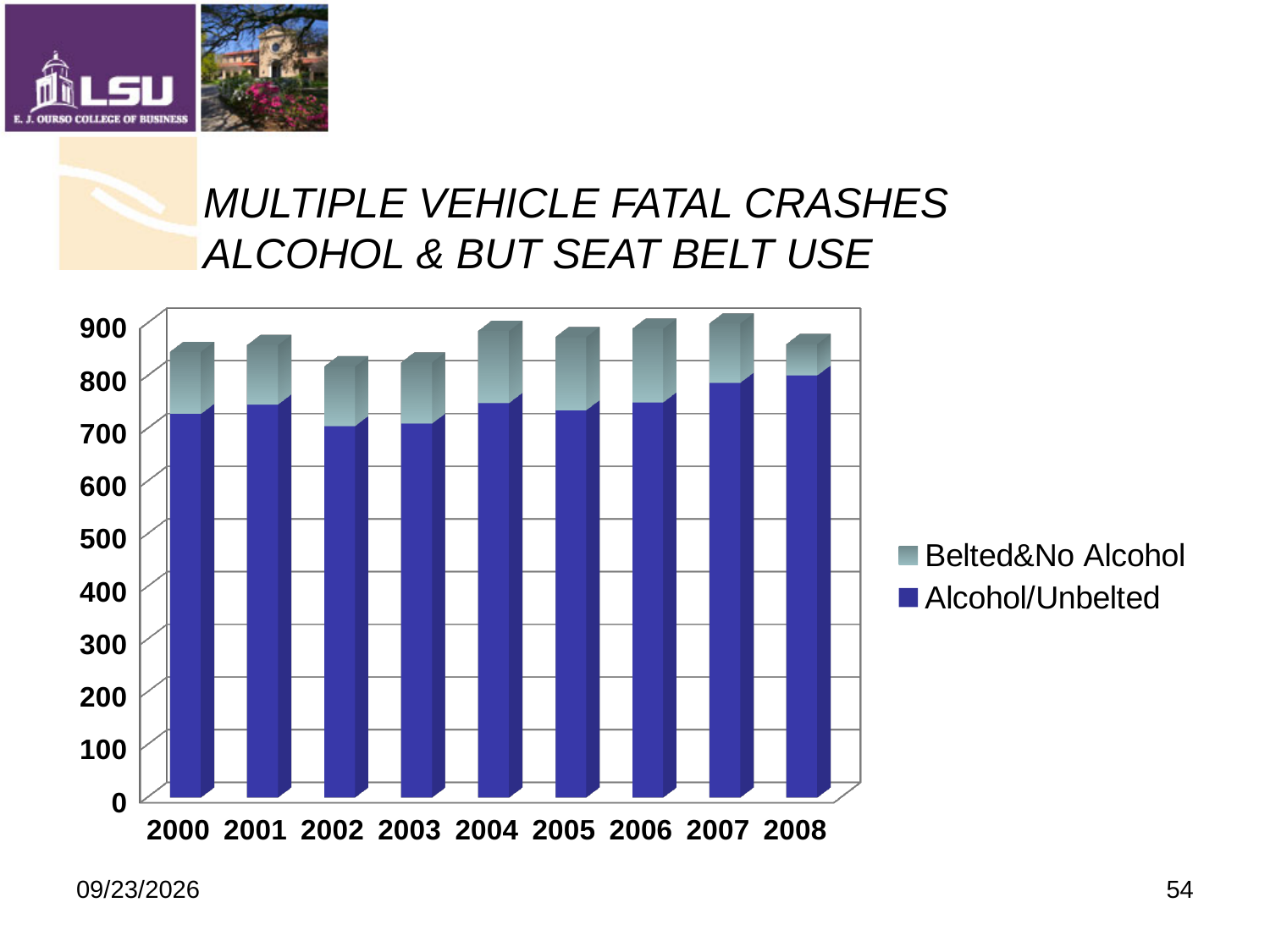
Is the Alcohol/Unbelted value for 2002 greater or less than 800? less Which series is shown in dark blue in the chart? Alcohol/Unbelted Is the total height of the stacked bar for 2007 greater or less than 800? greater Is the Alcohol/Unbelted value for 2008 greater or less than 700? greater Which year has the larger Alcohol/Unbelted value, 2000 or 2008? 2008 Which year has the taller total stacked bar, 2002 or 2004? 2004 Which series is stacked on top of the bars in the chart? Belted&No Alcohol How many series does the chart's legend list? 2 What kind of chart is shown on the slide? bar chart How many years are shown along the x axis of the chart? 9 Does the Alcohol/Unbelted value rise or fall from 2005 to 2008? rise